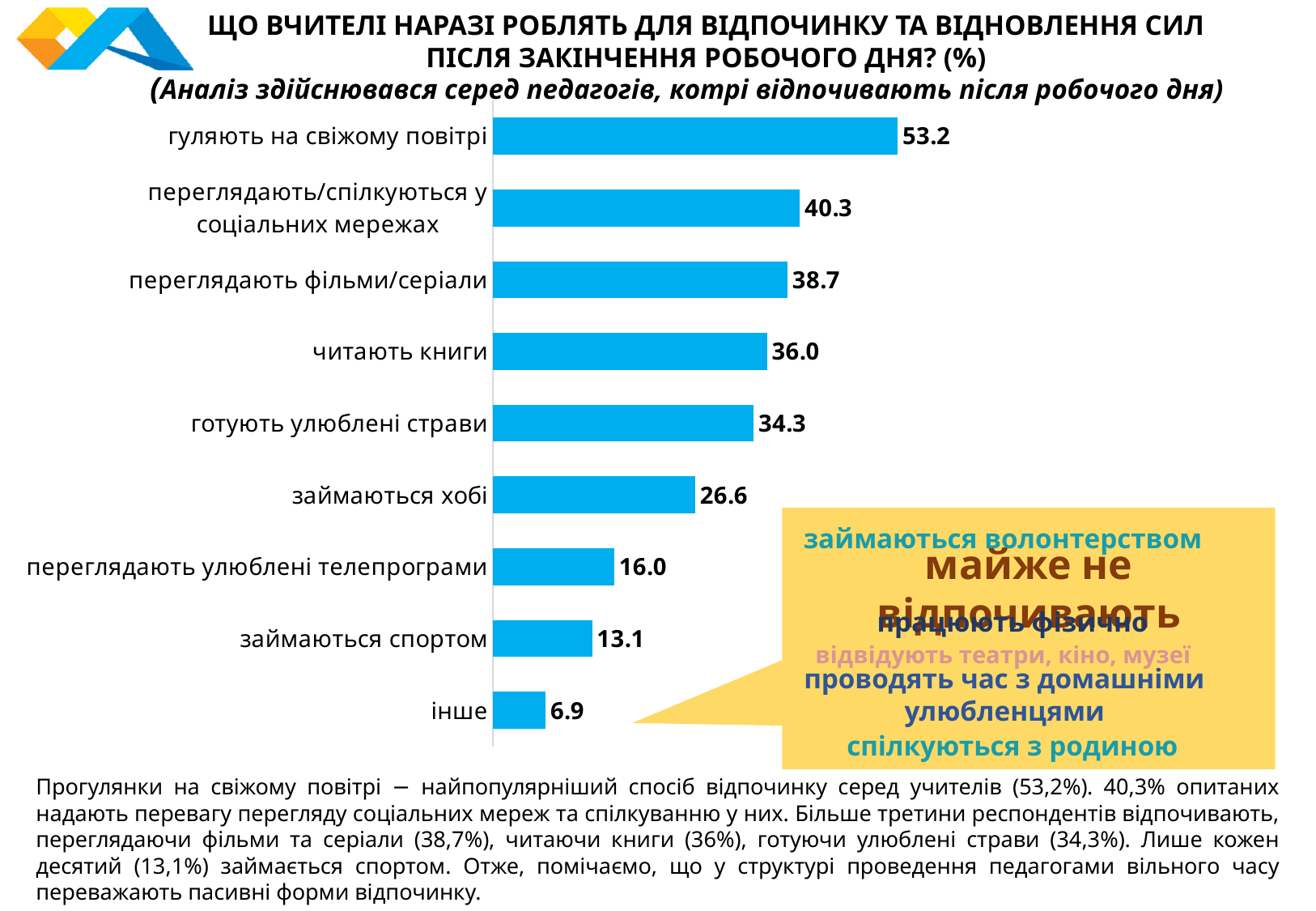
Which is larger: the value for "переглядають фільми/серіали" or the value for "готують улюблені страви"? переглядають фільми/серіали What is the value for "переглядають улюблені телепрограми"? 16.0 How many categories are plotted in the chart? 9 What is the value for "гуляють на свіжому повітрі"? 53.2 What colour are the bars in the chart? blue Which category has the lowest value? інше Which category has the highest value? гуляють на свіжому повітрі What type of chart is shown on the slide? bar chart What is the difference between the values for "гуляють на свіжому повітрі" and "переглядають/спілкуються у соціальних мережах"? 12.9 What is the value for "читають книги"? 36.0 What is the difference between the values for "займаються хобі" and "займаються спортом"? 13.5 What is the value for "займаються спортом"? 13.1